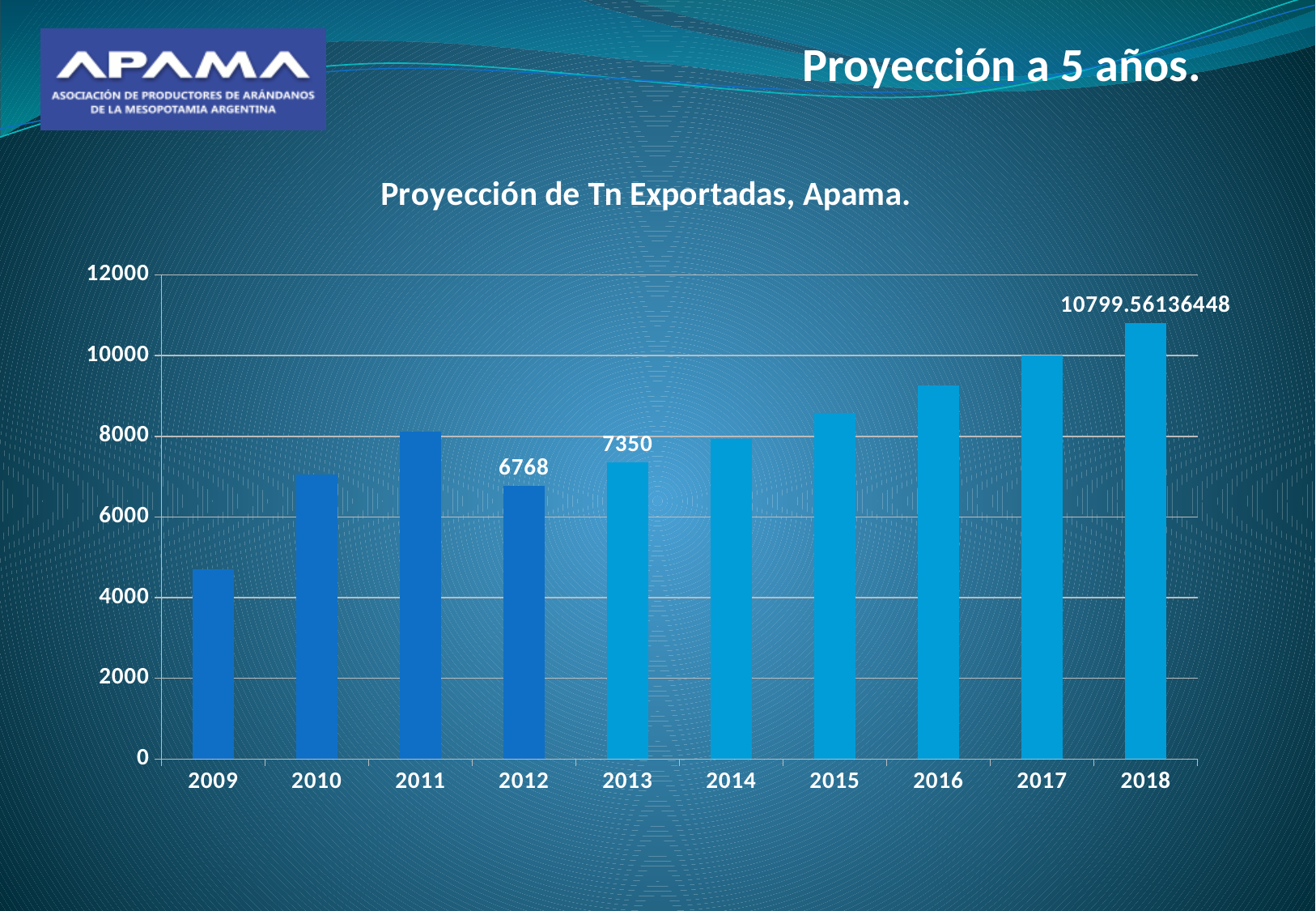
Which year has the lowest value? 2009 What is the difference between the values for 2013 and 2012? 582 What is the value for 2018? 10799.56136448 What kind of chart is shown on the slide? bar chart Do the values rise or fall from 2013 to 2018? rise What is the value for 2012? 6768 Which year has the highest value? 2018 How many years are shown on the x axis? 10 Which is larger, the value for 2011 or the value for 2010? 2011 Is the value for 2009 greater or less than 6000? less Is the value for 2016 greater or less than 8000? greater What is the value for 2013? 7350